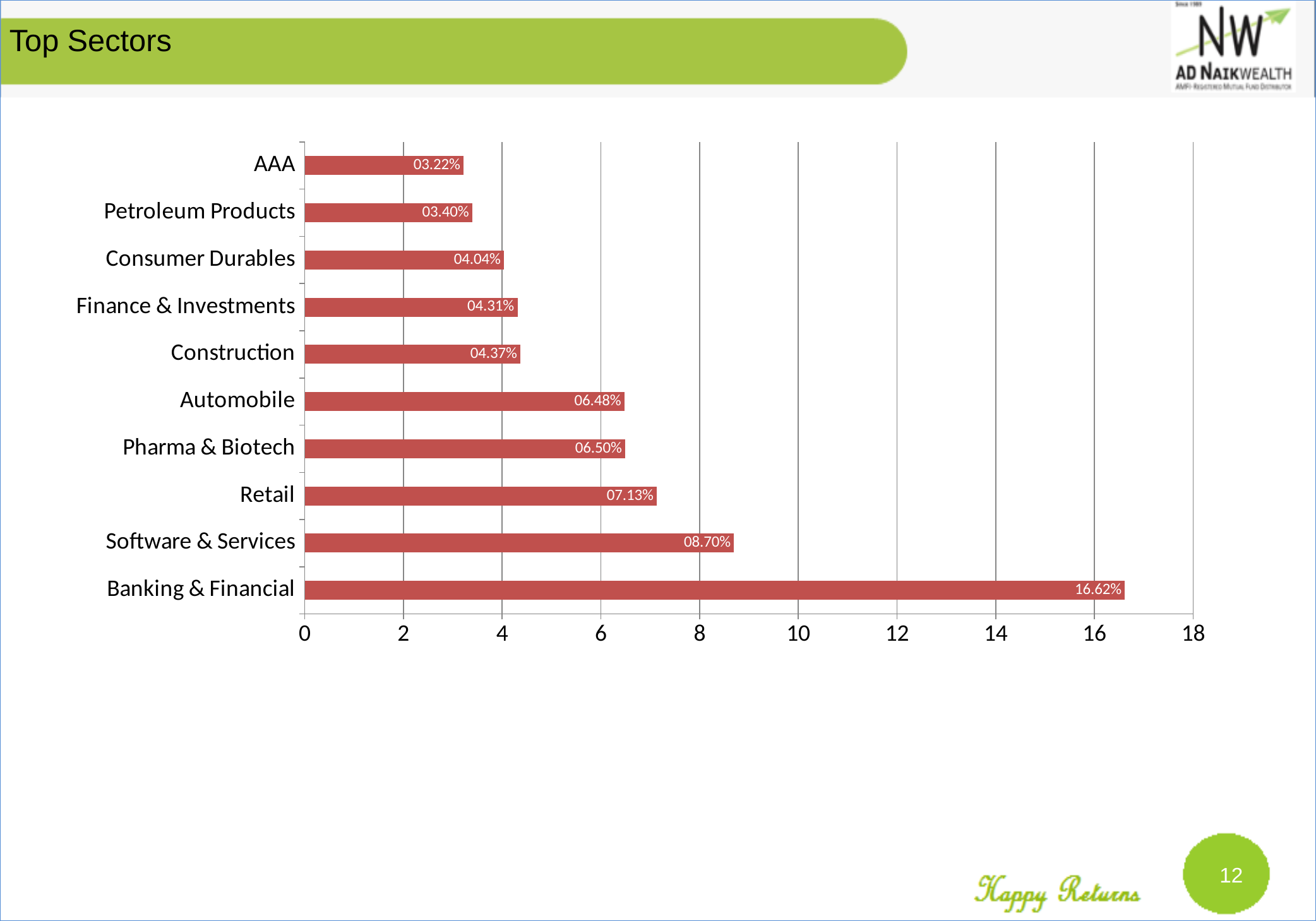
What is the title of the slide? Top Sectors What is the difference between the values for Banking & Financial and Software & Services? 7.92% Which sector has the lowest value? AAA What is the value for Consumer Durables? 04.04% Which is larger, the value for Retail or the value for Construction? Retail Which sector has the highest value? Banking & Financial What kind of chart is shown on the slide? Bar chart What is the value for Software & Services? 08.70% How many sectors are shown in the chart? 10 What is the difference between the values for Retail and Automobile? 0.65% What is the value for AAA? 03.22% What is the value for Banking & Financial? 16.62%